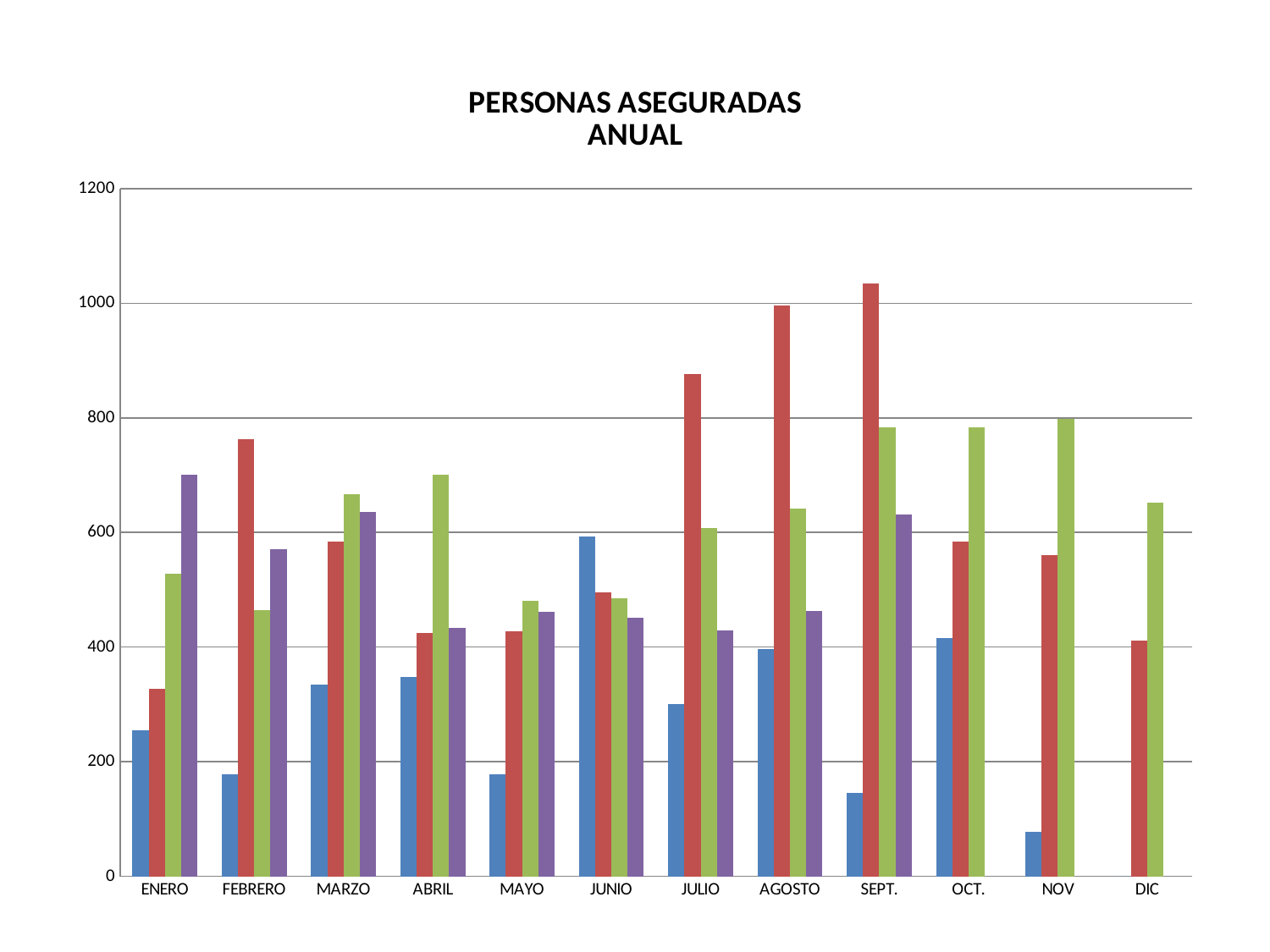
What kind of chart is shown on the slide? bar chart In which month is the blue bar the highest? JUNIO Is the red bar for AGOSTO greater or less than 800? greater How many bars are shown for ENERO? 4 In which month is the purple bar the highest? ENERO In FEBRERO, which is larger, the red bar or the green bar? the red bar How many months are shown along the x axis of the chart? 12 In which month is the red bar the highest? SEPT. Is the blue bar for NOV greater or less than 200? less What is the title of the chart? PERSONAS ASEGURADAS ANUAL Is the green bar for ABRIL greater or less than 600? greater